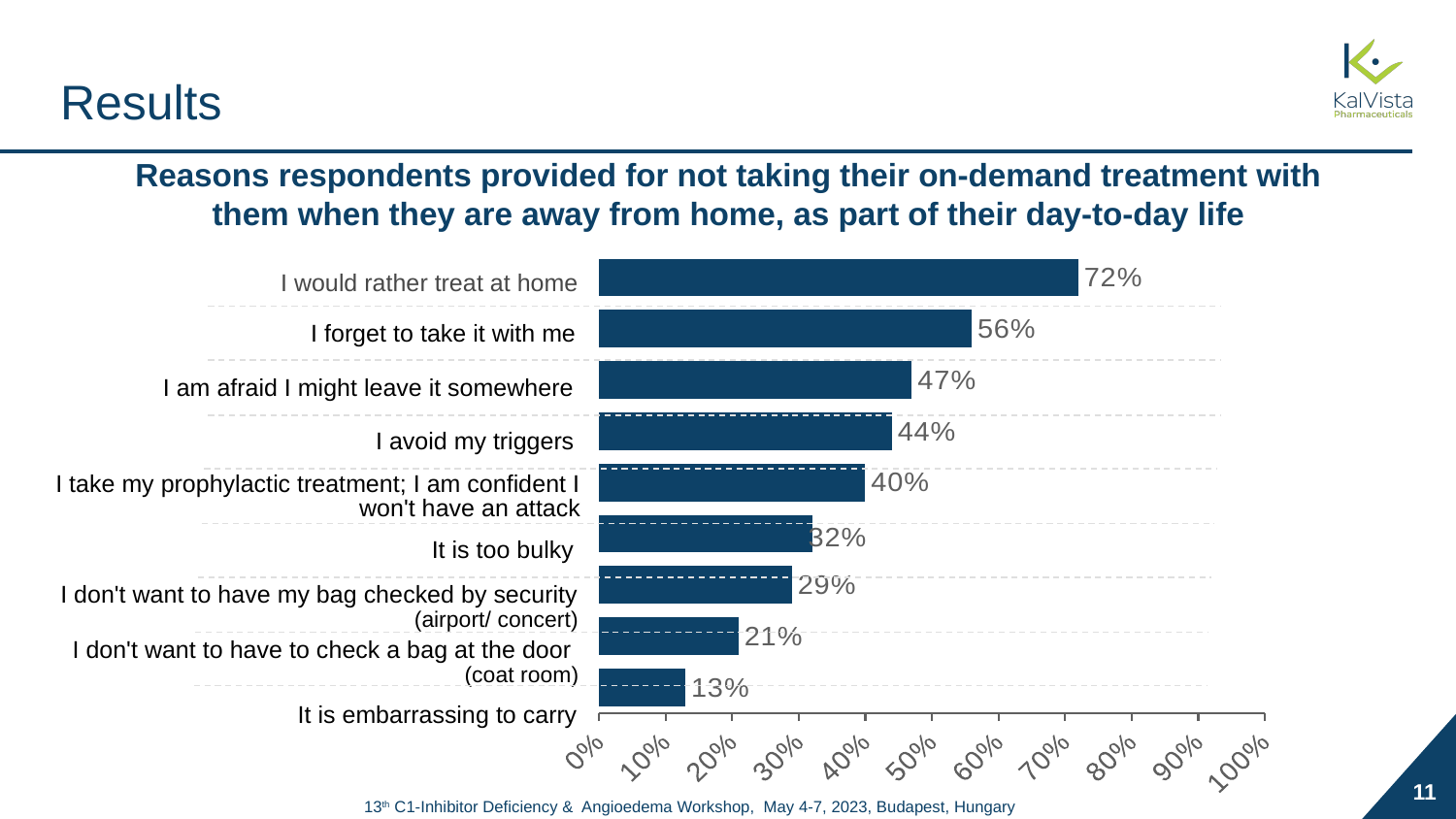
What is the value for "It is embarrassing to carry"? 13% Which reason has the lowest percentage of respondents? It is embarrassing to carry What is the value for "I forget to take it with me"? 56% What percentage is shown for "It is too bulky"? 32% What is the difference between the values for "I don't want to have my bag checked by security (airport/ concert)" and "I don't want to have to check a bag at the door (coat room)"? 8% What percentage of respondents said "I would rather treat at home"? 72% How many reasons are plotted in the chart? 9 What is the difference between the values for "I would rather treat at home" and "I forget to take it with me"? 16% Which is larger: the value for "I avoid my triggers" or the value for "I am afraid I might leave it somewhere"? I am afraid I might leave it somewhere What kind of chart is shown on the slide? Bar chart Is the value for "I take my prophylactic treatment; I am confident I won't have an attack" greater or less than 50%? less Which reason has the highest percentage of respondents? I would rather treat at home